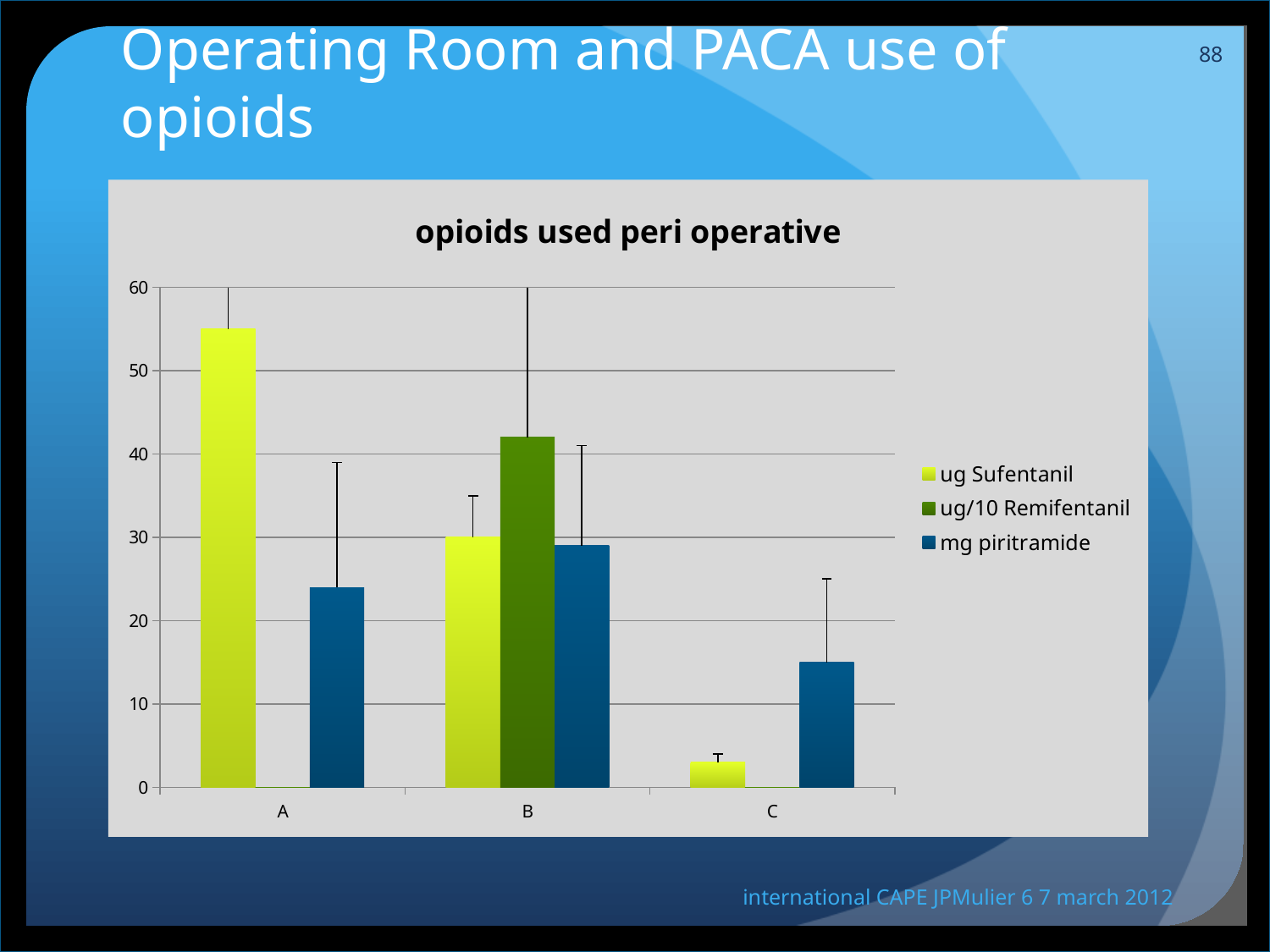
What kind of chart is shown on the slide? bar chart Is the ug Sufentanil value for A greater or less than 50? greater Which category has the highest ug/10 Remifentanil value? B Is the mg piritramide value for C greater or less than 20? less In category B, which is larger: ug Sufentanil or ug/10 Remifentanil? ug/10 Remifentanil How many categories are shown on the x axis? 3 What is the title of the chart? opioids used peri operative How many series does the legend list? 3 Which category has the highest ug Sufentanil value? A Which category has the lowest mg piritramide value? C Which category has the lowest ug Sufentanil value? C Is the ug/10 Remifentanil value for B greater or less than 40? greater